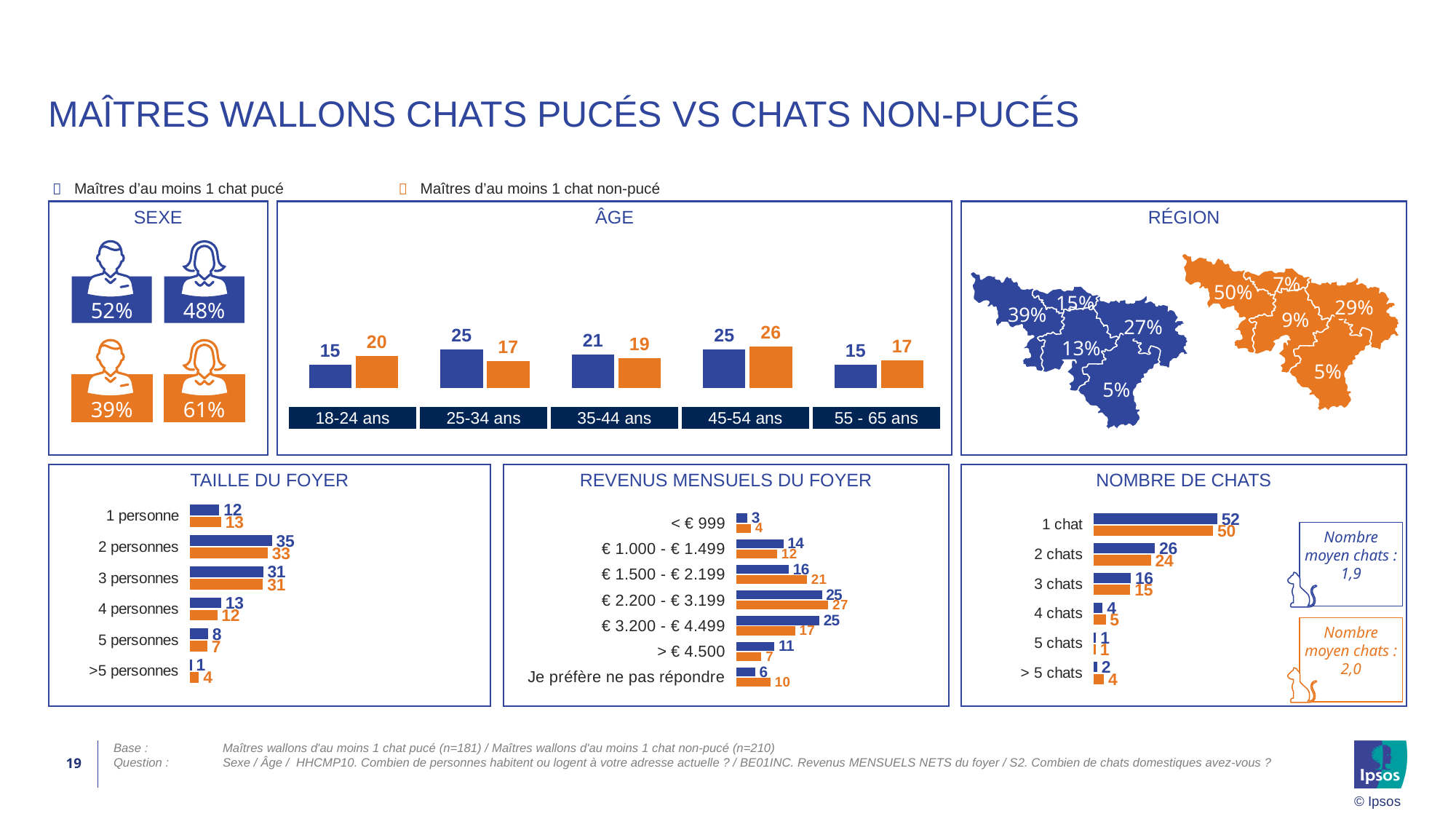
In the REVENUS MENSUELS DU FOYER chart, what is the value for € 3.200 - € 4.499 among owners of at least one microchipped cat? 25 In the ÂGE chart, what is the value for 18-24 ans among owners of at least one non-microchipped cat (chat non-pucé)? 20 In the TAILLE DU FOYER chart, what is the value for 2 personnes among owners of at least one microchipped cat? 35 In the ÂGE chart, how many age groups are shown on the x axis? 5 In the ÂGE chart, which age group has the highest value for owners of at least one non-microchipped cat? 45-54 ans What type of chart is the ÂGE chart? bar chart In the ÂGE chart, what is the value for 25-34 ans among owners of at least one microchipped cat (chat pucé)? 25 In the TAILLE DU FOYER chart, what is the difference between the microchipped and non-microchipped values for >5 personnes? 3 In the NOMBRE DE CHATS chart, what is the value for 1 chat among owners of at least one non-microchipped cat? 50 In the NOMBRE DE CHATS chart, what is the difference between the microchipped and non-microchipped values for 2 chats? 2 In the REVENUS MENSUELS DU FOYER chart, which is larger for € 1.500 - € 2.199: the microchipped value or the non-microchipped value? non-microchipped (21) In the REVENUS MENSUELS DU FOYER chart, which income category has the lowest value for owners of at least one microchipped cat? < € 999